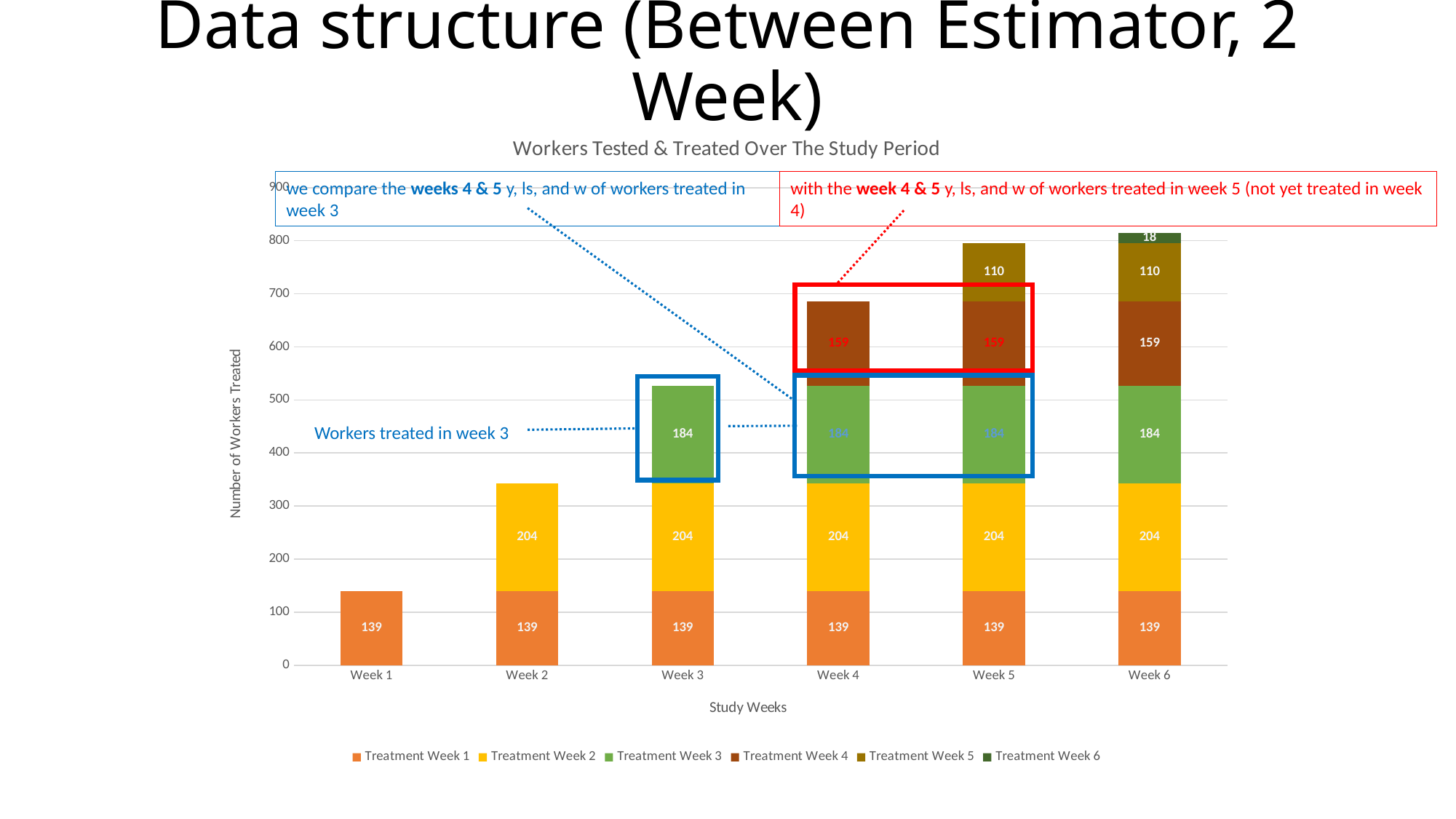
What is the value of Treatment Week 6 in Week 6? 18 What type of chart is shown on the slide? Stacked bar chart What is the value of Treatment Week 3 in Week 5? 184 Which study week has the lowest total number of workers treated? Week 1 How many study weeks are shown on the x axis? 6 What is the value of Treatment Week 1 in Week 4? 139 How many series does the legend list? 6 What is the total of the stacked bar for Week 3? 527 What is the difference between the Treatment Week 2 value and the Treatment Week 4 value in Week 6? 45 What is the title of the chart? Workers Tested & Treated Over The Study Period What is the total of the stacked bar for Week 6? 814 Do the total bar heights rise or fall from Week 1 to Week 6? Rise